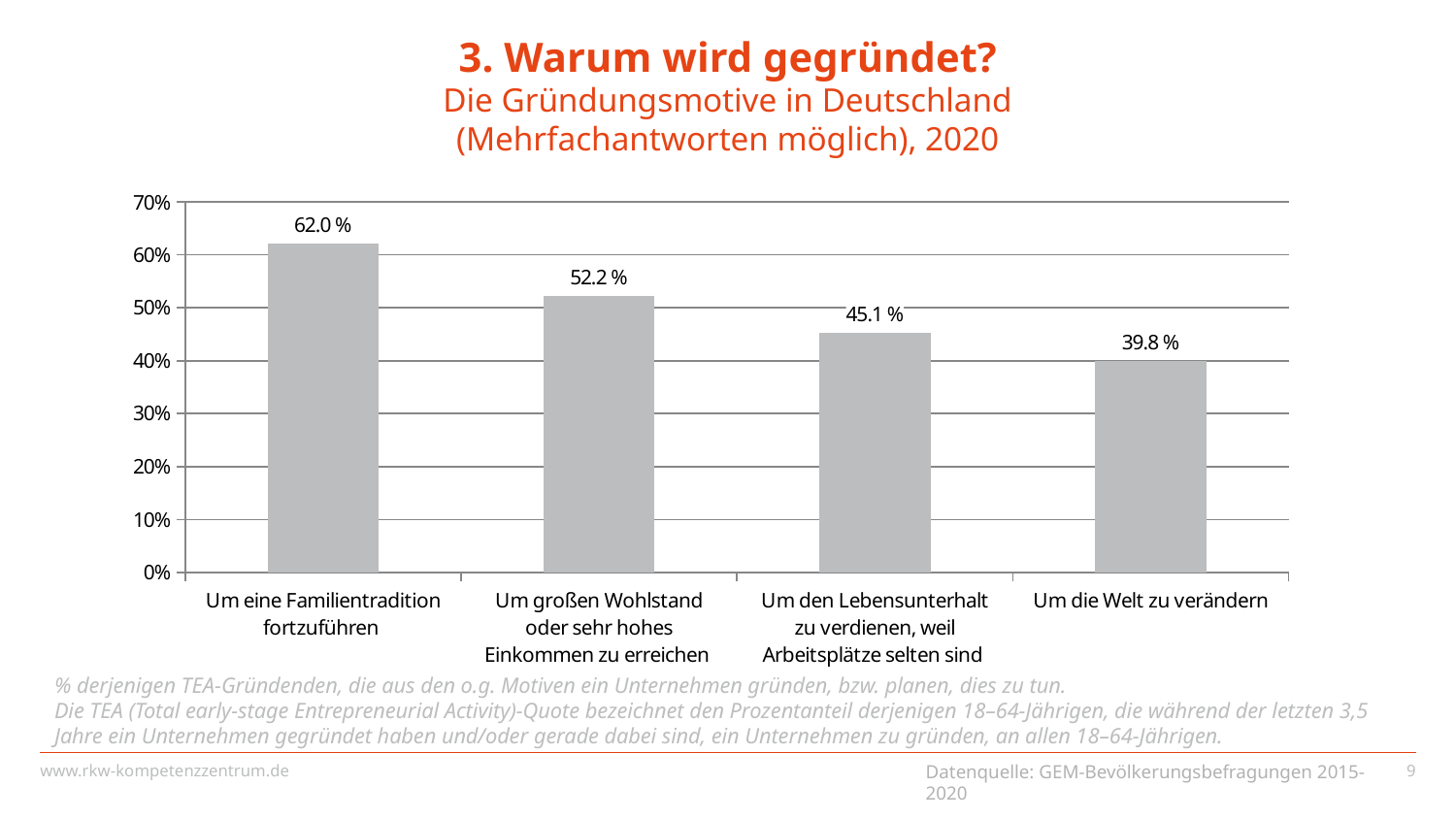
Which category has the highest value? Um eine Familientradition fortzuführen What is the value for "Um die Welt zu verändern"? 39.8 % Which category has the lowest value? Um die Welt zu verändern Is the value for "Um den Lebensunterhalt zu verdienen, weil Arbeitsplätze selten sind" greater or less than 50%? less Which is larger: the value for "Um großen Wohlstand oder sehr hohes Einkommen zu erreichen" or for "Um die Welt zu verändern"? Um großen Wohlstand oder sehr hohes Einkommen zu erreichen What kind of chart is shown on the slide? bar chart What is the value for "Um den Lebensunterhalt zu verdienen, weil Arbeitsplätze selten sind"? 45.1 % What is the value for "Um eine Familientradition fortzuführen"? 62.0 % What is the difference between the values for "Um eine Familientradition fortzuführen" and "Um großen Wohlstand oder sehr hohes Einkommen zu erreichen"? 9.8 % Do the values rise or fall from left to right along the x axis? fall What is the data source named at the bottom of the slide? GEM-Bevölkerungsbefragungen 2015-2020 How many categories are shown in the chart? 4